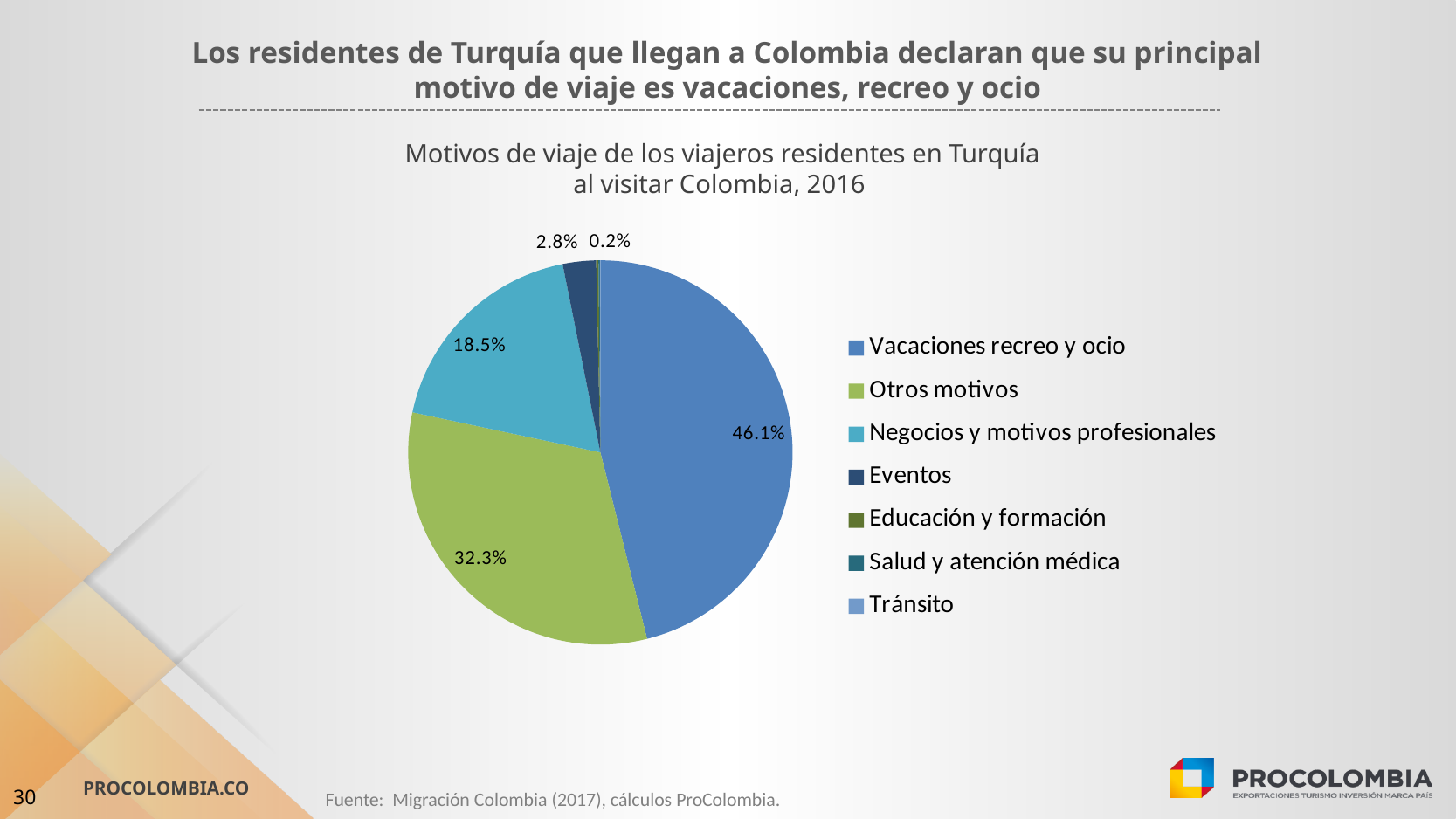
What percentage of the pie corresponds to 'Vacaciones recreo y ocio'? 46.1% Which is larger, the share for 'Otros motivos' or for 'Negocios y motivos profesionales'? Otros motivos What percentage is shown for 'Negocios y motivos profesionales'? 18.5% What is the title of the chart? Motivos de viaje de los viajeros residentes en Turquía al visitar Colombia, 2016 What percentage is shown for 'Otros motivos'? 32.3% What is the difference in percentage points between 'Vacaciones recreo y ocio' and 'Otros motivos'? 13.8 percentage points What is the combined share of 'Vacaciones recreo y ocio', 'Otros motivos' and 'Negocios y motivos profesionales'? 96.9% What percentage is shown for 'Eventos'? 2.8% How many categories does the legend list? 7 What is the smallest percentage label printed on the pie chart? 0.2% Which travel motive has the largest share of the pie? Vacaciones recreo y ocio What kind of chart is shown on the slide? Pie chart